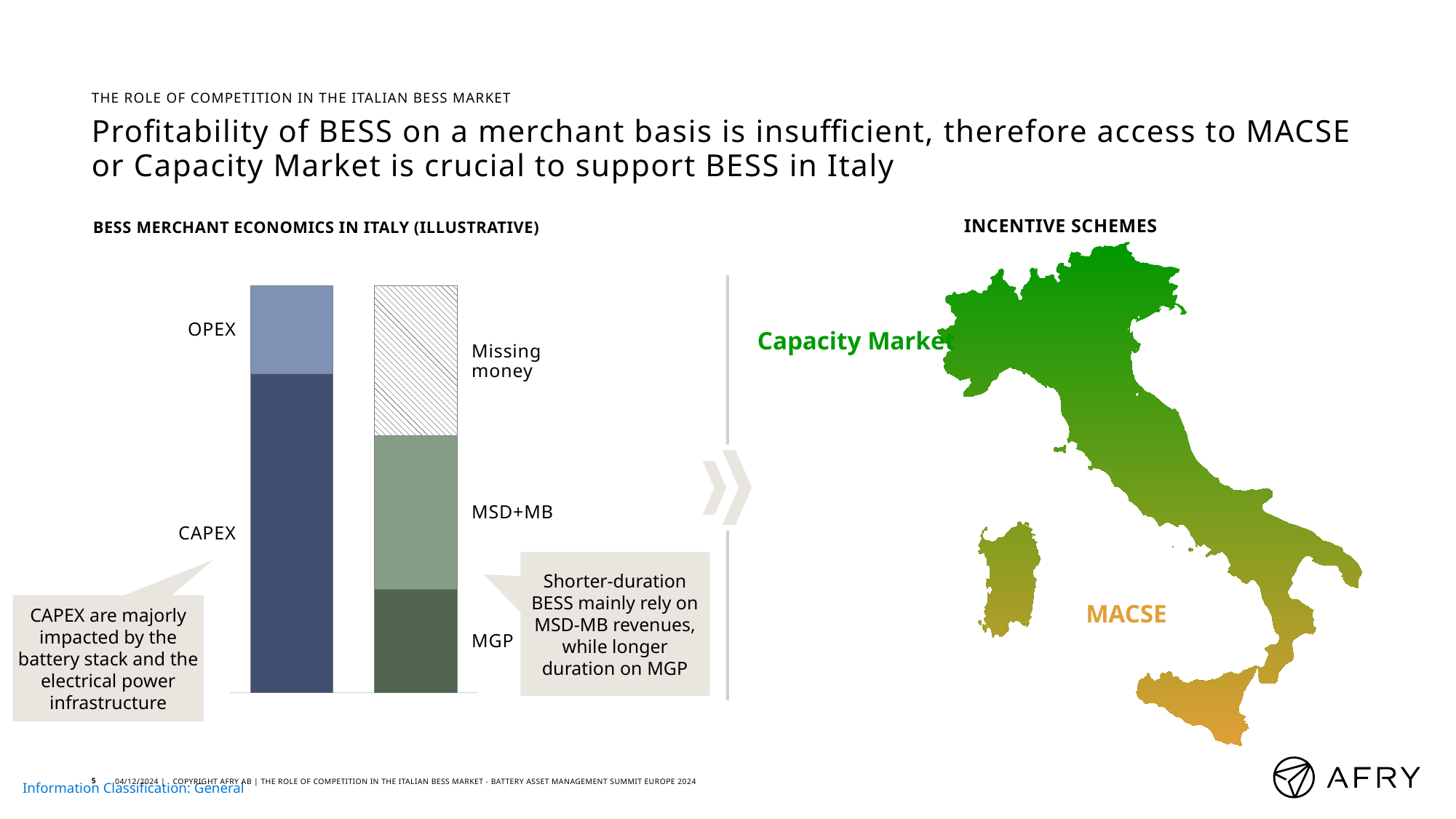
How many segments make up the right bar of the BESS merchant economics chart? 3 What kind of chart is shown under the heading 'BESS MERCHANT ECONOMICS IN ITALY (ILLUSTRATIVE)'? Stacked bar chart In the BESS merchant economics chart, which is the smallest segment of the right bar? MGP In the BESS merchant economics chart, which segment of the left bar is larger, CAPEX or OPEX? CAPEX In the BESS merchant economics chart, which segment sits at the top of the left bar? OPEX How many bars are plotted in the BESS merchant economics chart? 2 In the BESS merchant economics chart, which segment of the right bar is larger, MSD+MB or MGP? MSD+MB How many segments make up the left bar of the BESS merchant economics chart? 2 In the BESS merchant economics chart, which segment sits at the bottom of the right bar? MGP In the BESS merchant economics chart, which segment of the right bar is drawn with a hatched pattern? Missing money What is the title of the bar chart on the left of the slide? BESS MERCHANT ECONOMICS IN ITALY (ILLUSTRATIVE)